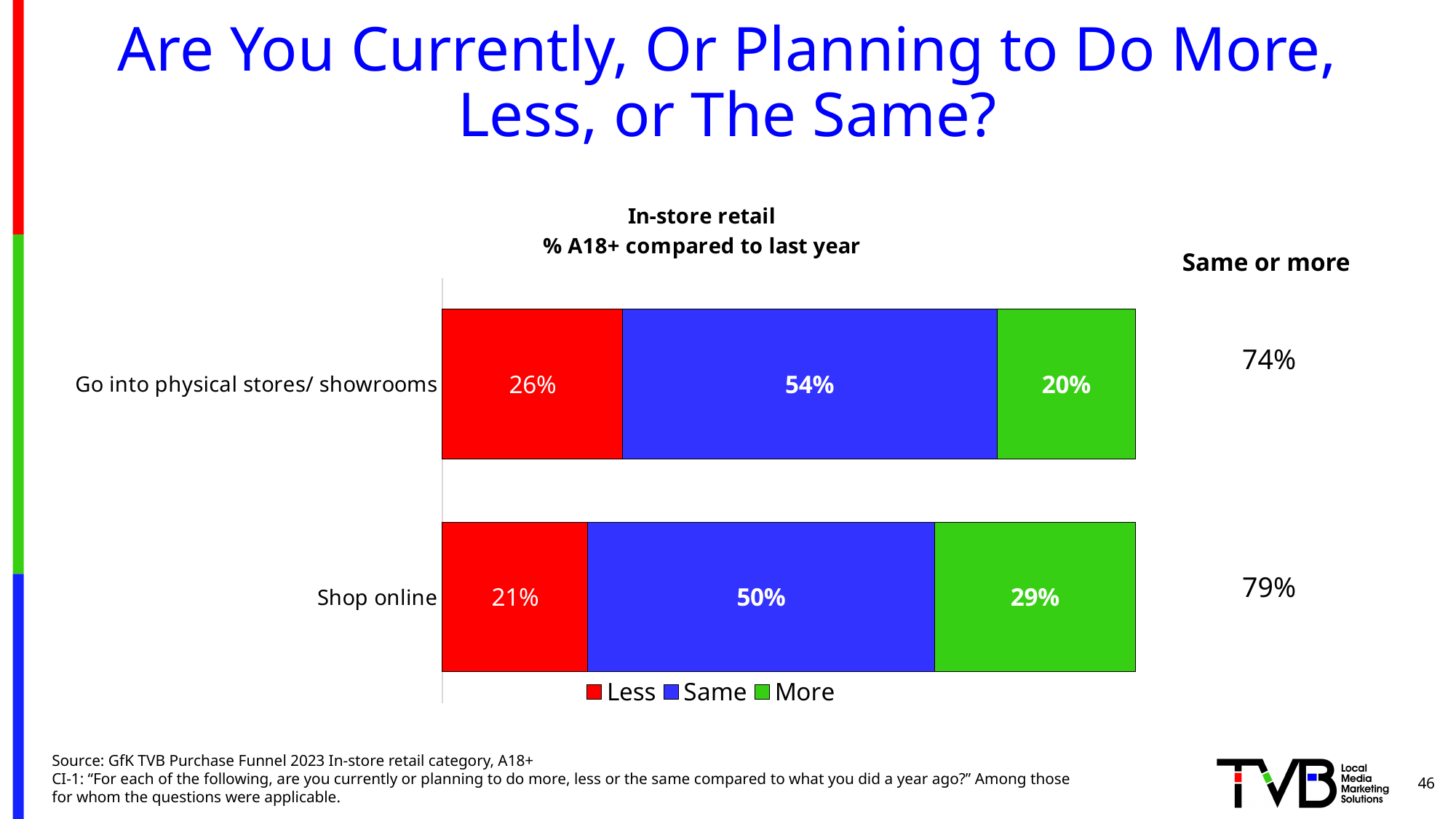
What percentage of respondents say they will do less going into physical stores/showrooms? 26% What is the total of the stacked bar for Shop online? 100% What kind of chart is shown on the slide? Stacked bar chart Which category has the higher 'More' percentage, Go into physical stores/ showrooms or Shop online? Shop online What percentage of respondents say they will shop online the same as last year? 50% Which colour represents the 'Same' series in the chart? Blue How many categories are shown in the chart? 2 What is the difference between the 'Same' percentages for Go into physical stores/ showrooms and Shop online? 4% What is the 'Same or more' figure shown for Go into physical stores/ showrooms? 74% What percentage of respondents say they will shop online more? 29% What is the difference between the 'Less' percentages for Go into physical stores/ showrooms and Shop online? 5% How many series does the legend list? 3